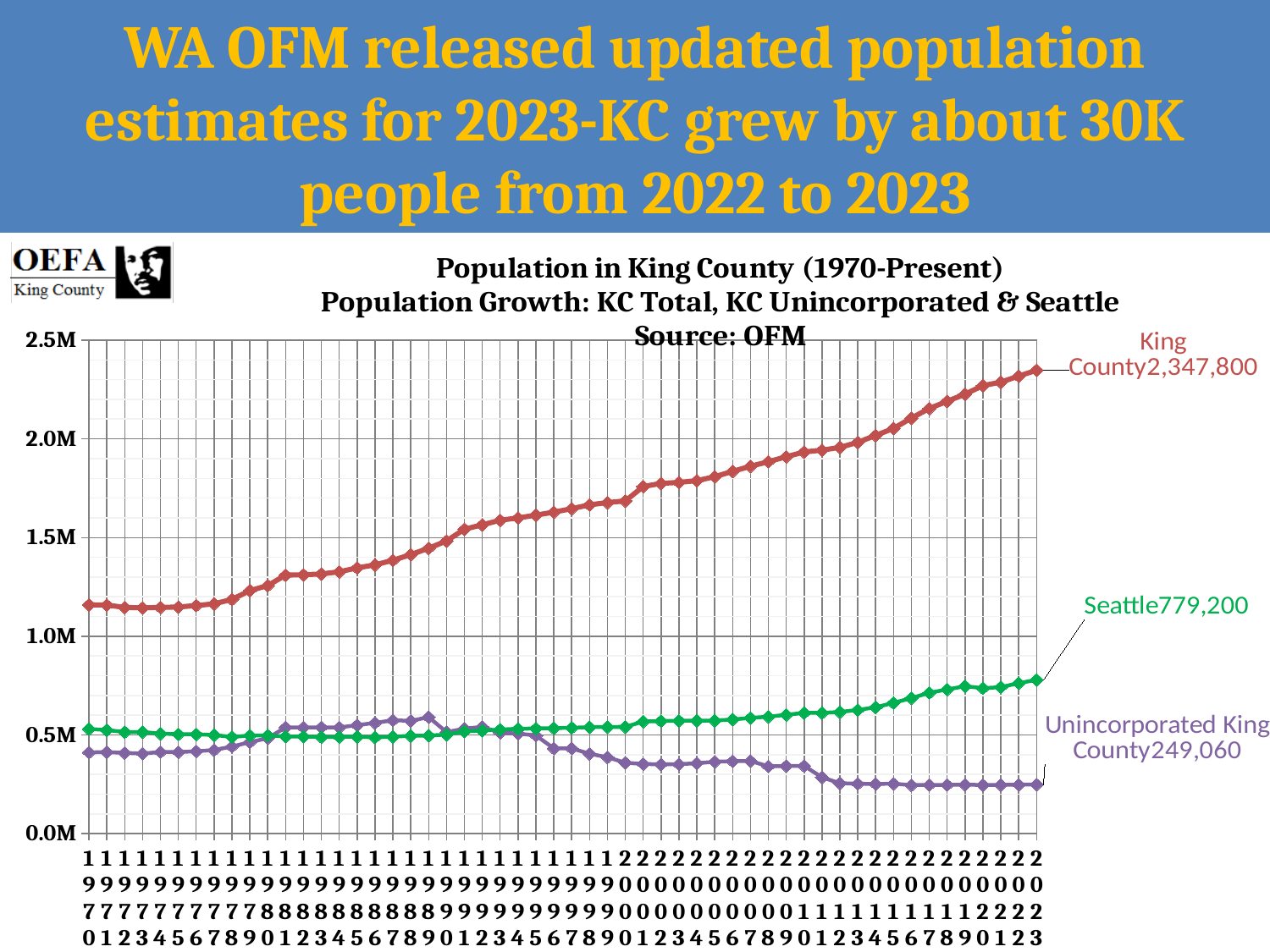
What is the King County population value labelled at the end of the line in 2023? 2,347,800 What is the difference between the King County and Seattle values labelled for 2023? 1,568,600 Does the King County line rise or fall from 1970 to 2023? Rises What kind of chart is shown on the slide? Line chart What is the Seattle population value labelled at the end of the line in 2023? 779,200 Which is larger in 2023, the Seattle value or the Unincorporated King County value? Seattle Which series has the highest value in 2023? King County Is the King County value for 1970 greater or less than 1.0M? greater What is the Unincorporated King County population value labelled at the end of the line in 2023? 249,060 How many series does the chart plot? 3 Is the Unincorporated King County value for 2023 greater or less than 0.5M? less Which series has the lowest value in 2023? Unincorporated King County